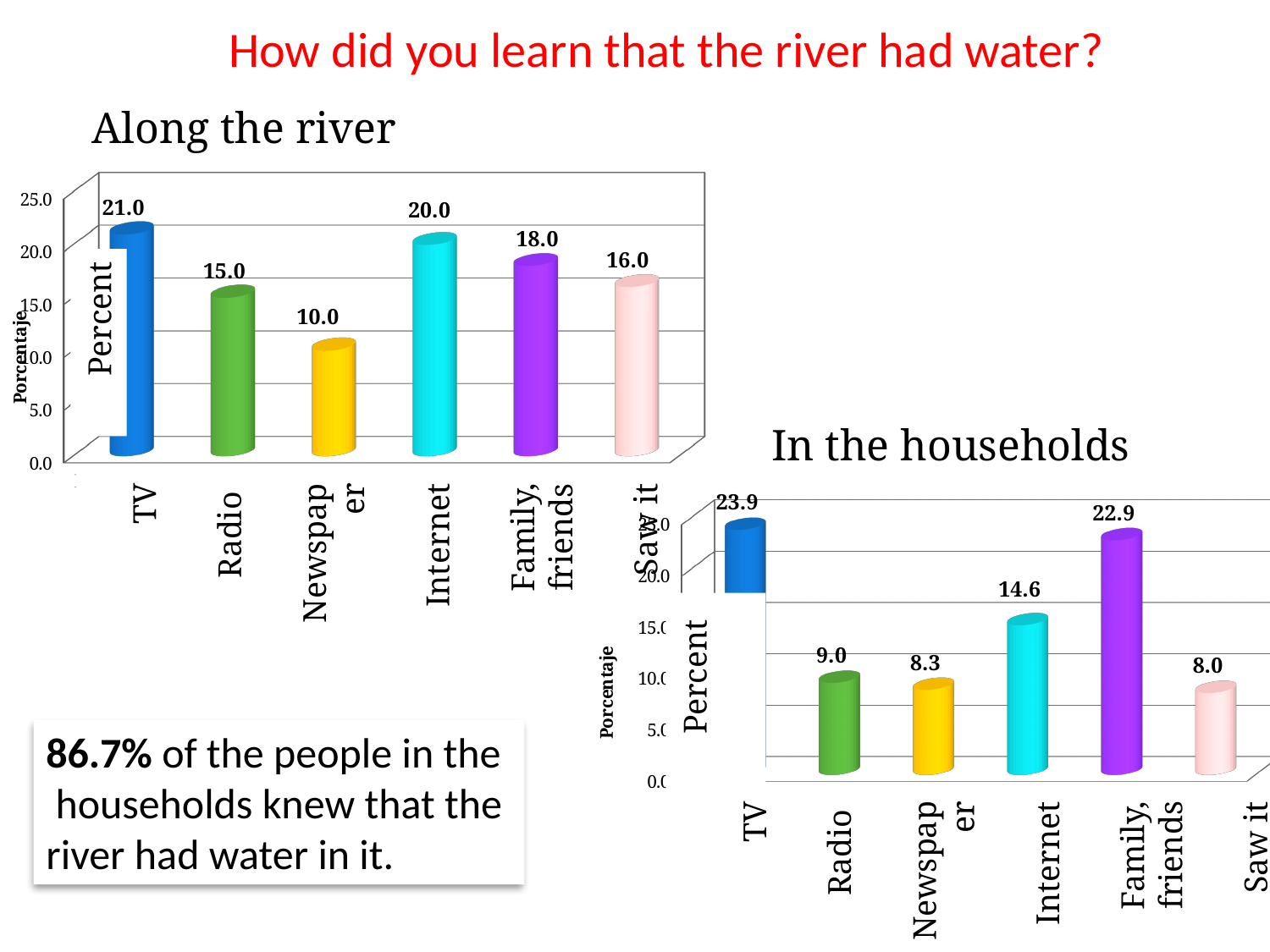
In the 'Along the river' chart, which category has the lowest value? Newspaper In the 'Along the river' chart, what is the difference between the values for TV and Radio? 6.0 What kind of chart is the 'Along the river' chart? Bar chart In the 'In the households' chart, which category has the highest value? TV In the 'Along the river' chart, which category has the highest value? TV How many categories are shown in the 'In the households' chart? 6 In the 'In the households' chart, what is the difference between the values for Family, friends and Internet? 8.3 In the 'In the households' chart, what is the value for Newspaper? 8.3 In the 'Along the river' chart, what is the value for Internet? 20.0 What is the label on the vertical axis of the 'In the households' chart? Porcentaje (Percent) In the 'Along the river' chart, which is larger, the value for Family, friends or the value for Saw it? Family, friends In the 'In the households' chart, which category has the lowest value? Saw it